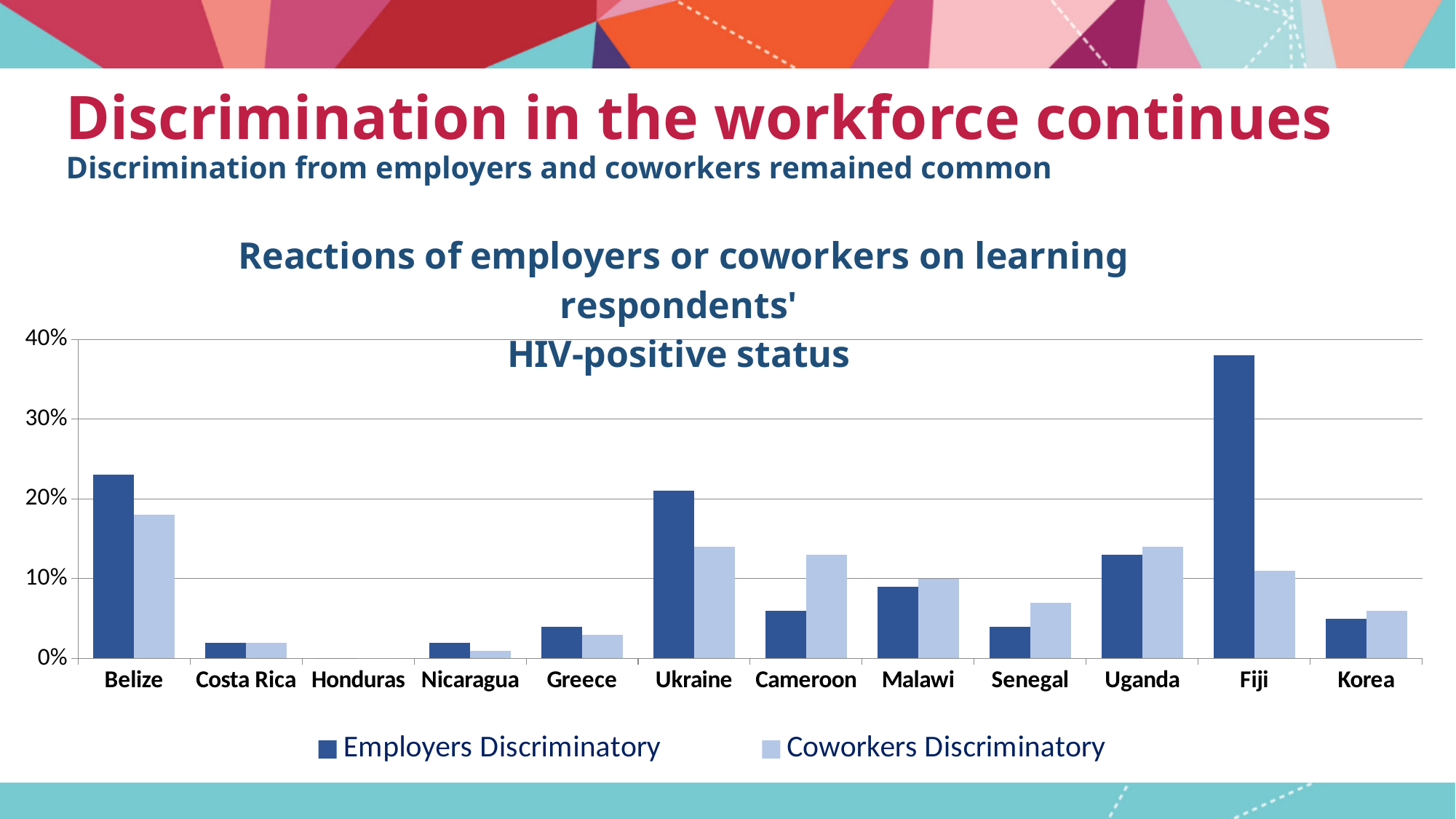
Which country shows the lowest values, with no visible bars for either series? Honduras For Belize, which series has the larger value: Employers Discriminatory or Coworkers Discriminatory? Employers Discriminatory Is the Employers Discriminatory value for Fiji greater or less than 30%? greater Which country has the highest value for Employers Discriminatory? Fiji What are the two series named in the chart's legend? Employers Discriminatory and Coworkers Discriminatory How many series does the chart's legend list? 2 Is the Employers Discriminatory value for Belize greater or less than 20%? greater How many countries are shown on the x axis of the chart? 12 Is the Coworkers Discriminatory value for Ukraine greater or less than 20%? less For Cameroon, which series has the larger value: Employers Discriminatory or Coworkers Discriminatory? Coworkers Discriminatory What kind of chart is shown on the slide? Bar chart Which country has the highest value for Coworkers Discriminatory? Belize